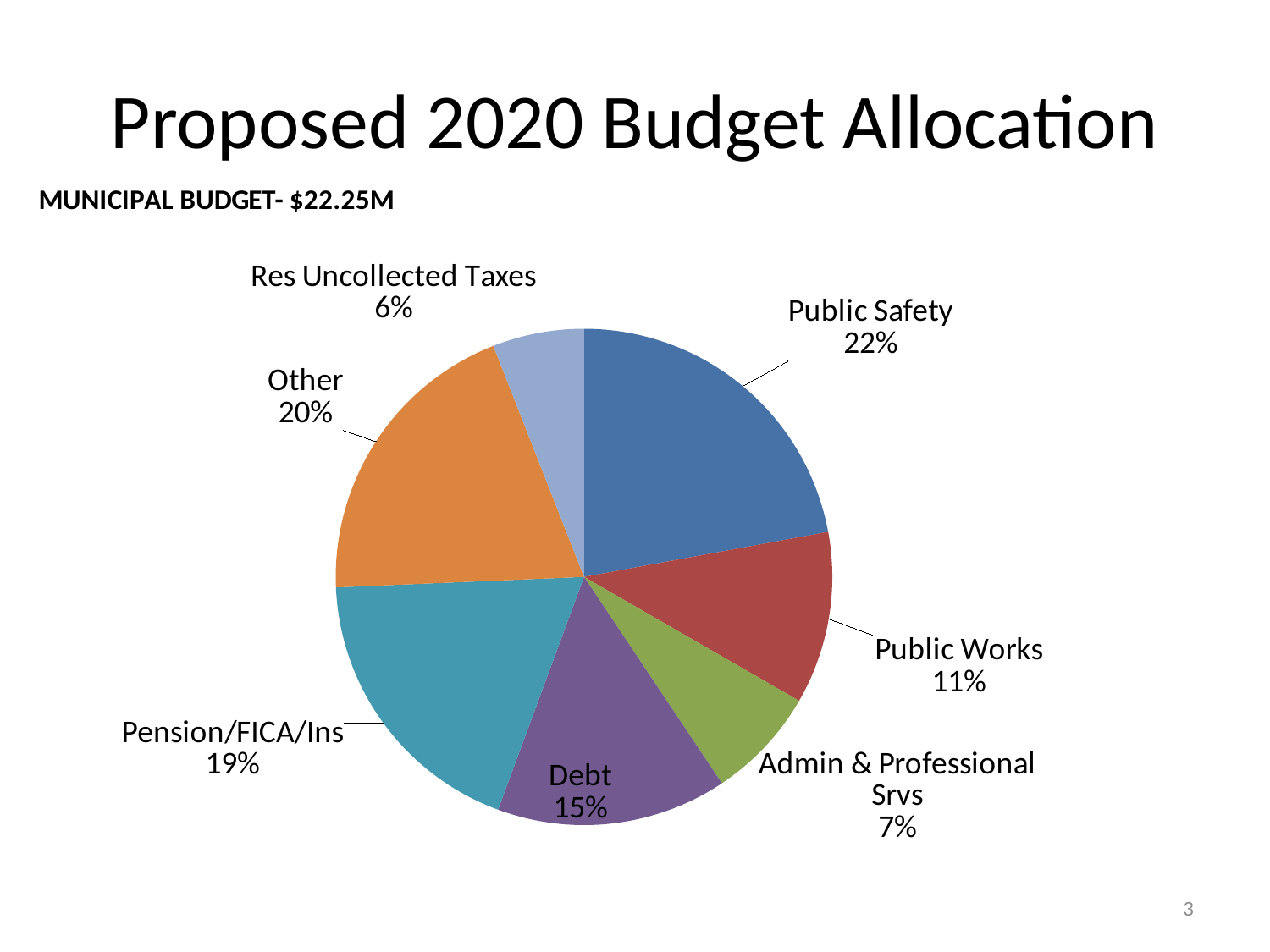
What share of the budget is allocated to Debt? 15% What share of the budget is allocated to Admin & Professional Srvs? 7% What is the title of the slide? Proposed 2020 Budget Allocation What is the difference in percentage points between Public Safety and Public Works? 11 How many slices does the pie chart have? 7 What kind of chart is shown on the slide? pie chart What share of the budget is allocated to Res Uncollected Taxes? 6% Which category has the smallest share of the budget? Res Uncollected Taxes What total municipal budget amount is stated on the slide? $22.25M Which category has the largest share of the budget? Public Safety Which is larger, the share for Other or the share for Pension/FICA/Ins? Other